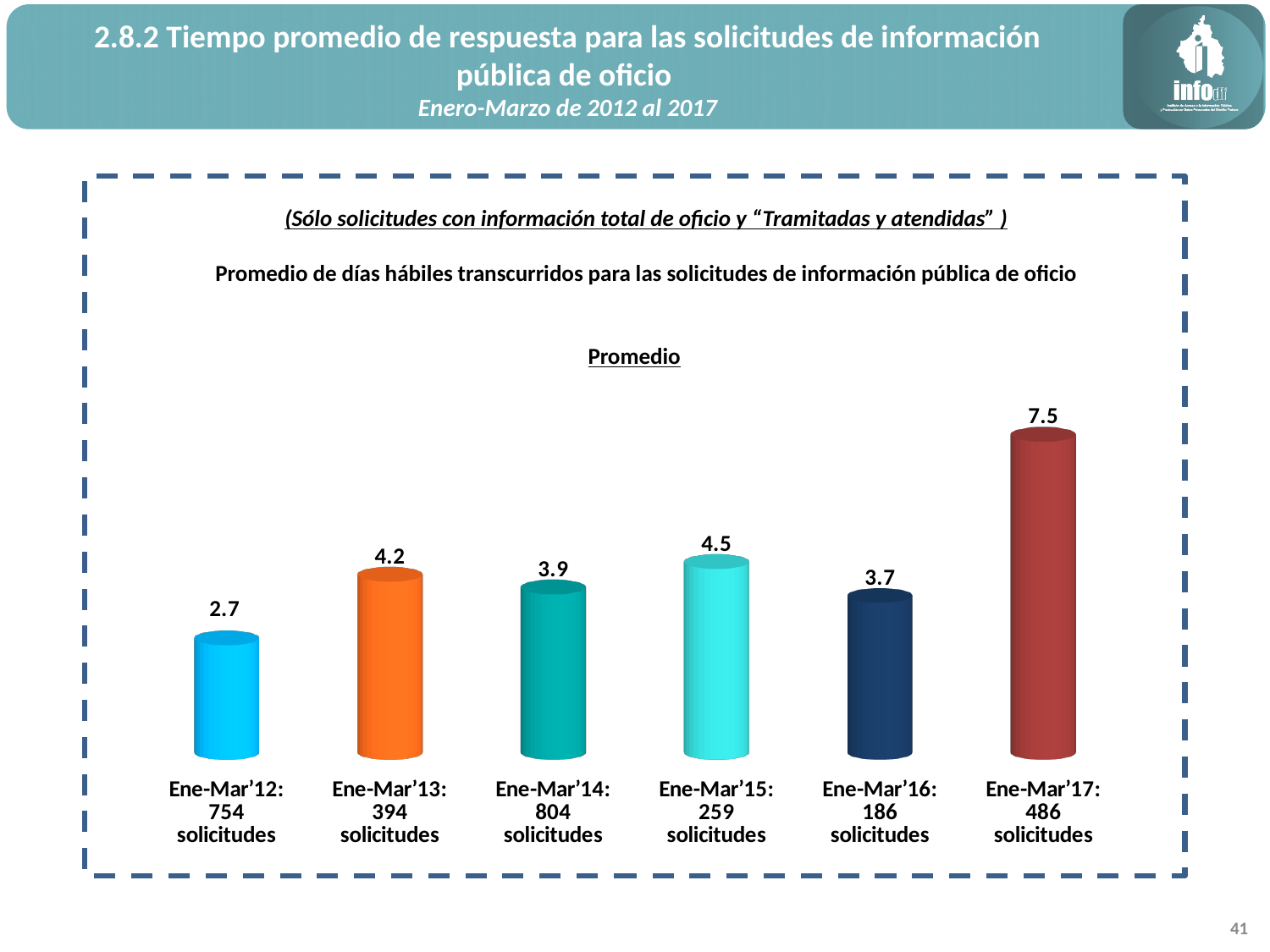
What is the underlined label shown above the bars? Promedio What kind of chart is shown on the slide? Bar chart Which period has the highest average? Ene-Mar'17 Which is larger, the average for Ene-Mar'15 or for Ene-Mar'16? Ene-Mar'15 How many solicitudes are listed under the Ene-Mar'14 label? 804 Which period has the lowest average? Ene-Mar'12 What is the average value shown for Ene-Mar'17? 7.5 What is the average value shown for Ene-Mar'12? 2.7 How many periods are plotted in the chart? 6 What is the average value shown for Ene-Mar'15? 4.5 What is the difference between the averages for Ene-Mar'17 and Ene-Mar'16? 3.8 What is the difference between the averages for Ene-Mar'13 and Ene-Mar'14? 0.3